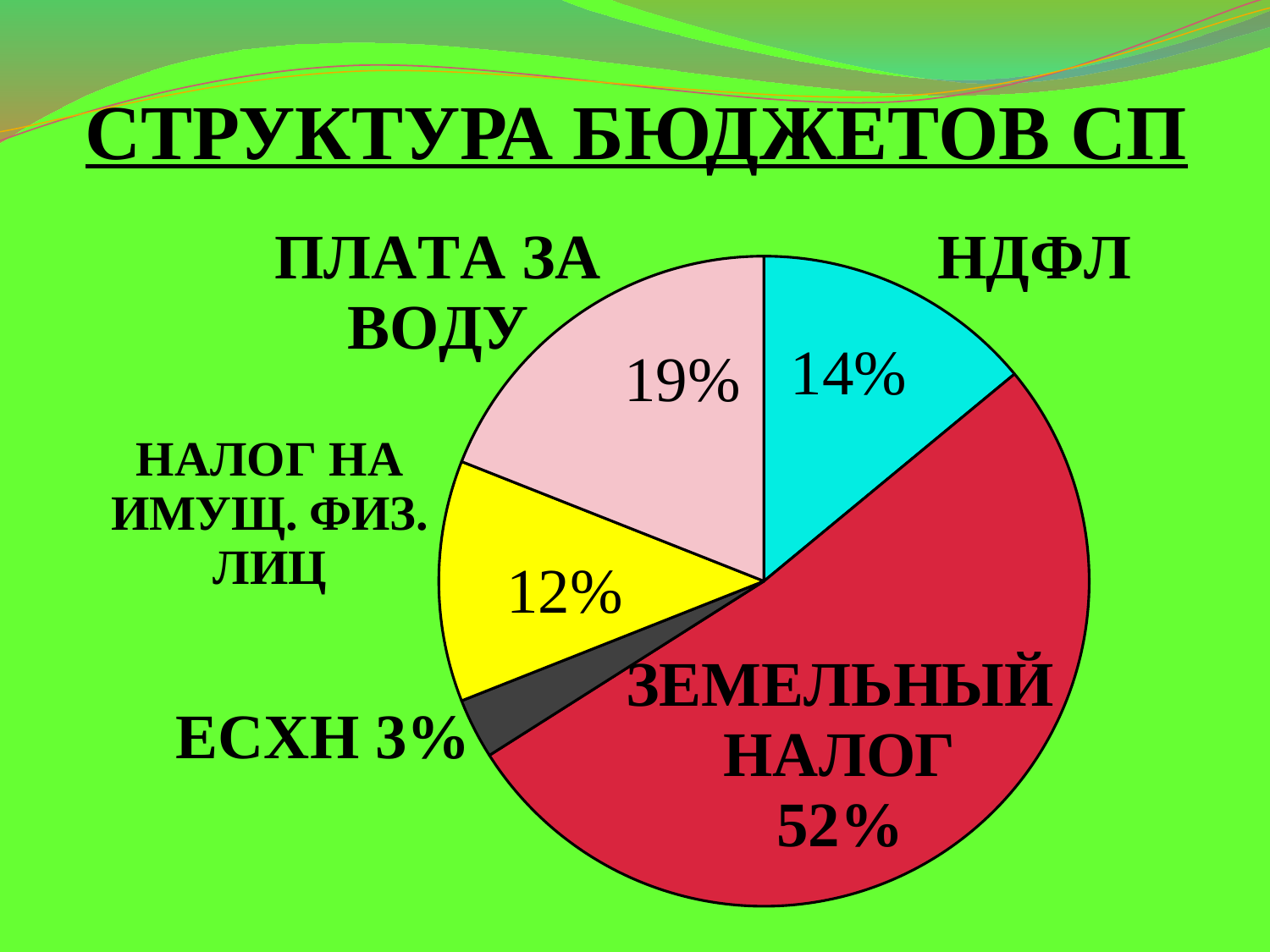
What share of the pie is ЗЕМЕЛЬНЫЙ НАЛОГ? 52% What is the difference between the shares of ПЛАТА ЗА ВОДУ and НДФЛ? 5% What is the title of the chart on the slide? СТРУКТУРА БЮДЖЕТОВ СП What kind of chart is shown on the slide? Pie chart Which category has the smallest share of the pie? ЕСХН How many slices does the pie chart have? 5 Which category has the largest share of the pie? ЗЕМЕЛЬНЫЙ НАЛОГ Which is larger, the share for НДФЛ or the share for НАЛОГ НА ИМУЩ. ФИЗ. ЛИЦ? НДФЛ What is the value shown for ПЛАТА ЗА ВОДУ? 19% What is the value shown for ЕСХН? 3% What is the value shown for НАЛОГ НА ИМУЩ. ФИЗ. ЛИЦ? 12% What is the value shown for НДФЛ? 14%